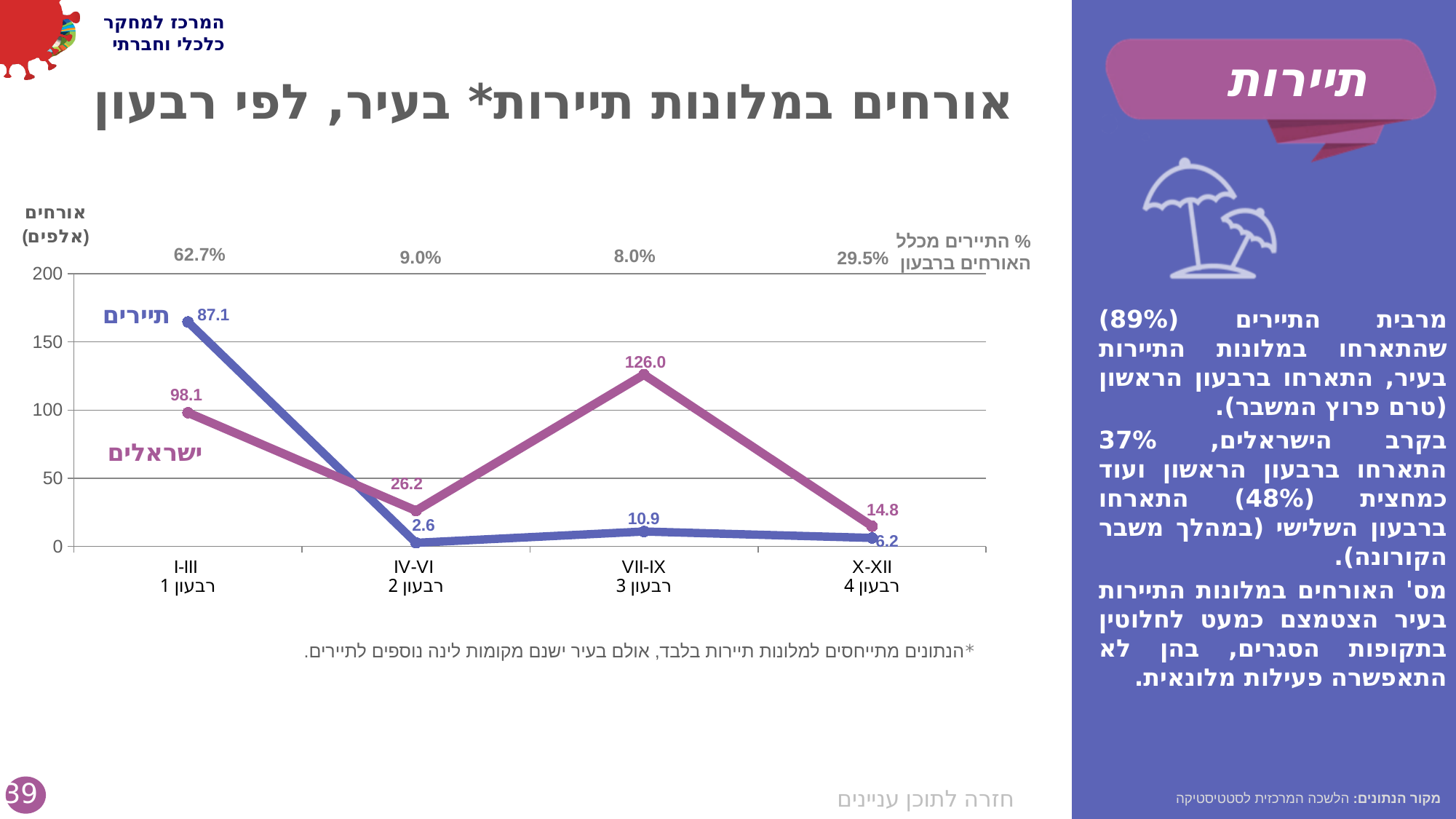
How many series does the chart show? 2 What percentage of all guests in רבעון 1 were tourists, according to the figures above the chart? 62.7% What is the value for תיירים in רבעון 2 (IV-VI)? 2.6 Which series has the larger value in רבעון 4 (X-XII), תיירים or ישראלים? ישראלים What type of chart is shown on the slide? line chart What is the difference between ישראלים and תיירים in רבעון 3 (VII-IX)? 115.1 What is the value for ישראלים in רבעון 3 (VII-IX)? 126.0 In which quarter is the value for ישראלים highest? רבעון 3 (VII-IX) What is the value for ישראלים in רבעון 4 (X-XII)? 14.8 In which quarter is the value for תיירים lowest? רבעון 2 (IV-VI) Is the value for ישראלים in רבעון 3 (VII-IX) greater or less than 100? greater How many quarters (categories) are plotted on the x axis? 4